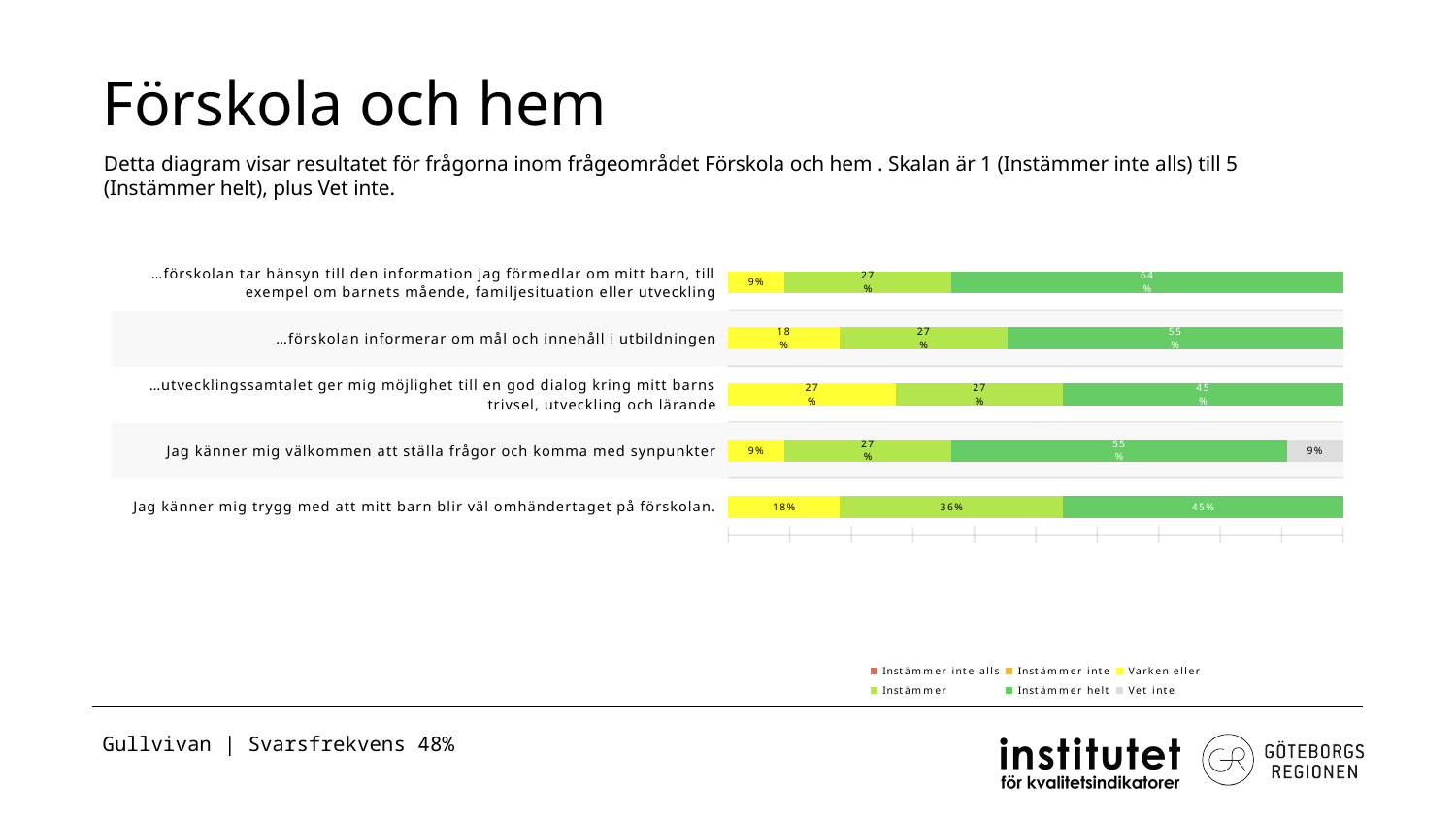
Which statement has the highest "Instämmer helt" share? …förskolan tar hänsyn till den information jag förmedlar om mitt barn, till exempel om barnets mående, familjesituation eller utveckling What is the "Instämmer" share for "Jag känner mig trygg med att mitt barn blir väl omhändertaget på förskolan."? 36% What kind of chart is shown on the slide? Stacked bar chart How many statements (bars) are shown in the chart? 5 What is the "Vet inte" share for "Jag känner mig välkommen att ställa frågor och komma med synpunkter"? 9% What is the "Varken eller" share for "…förskolan informerar om mål och innehåll i utbildningen"? 18% Which has the larger "Instämmer helt" share: "…förskolan informerar om mål och innehåll i utbildningen" or "…utvecklingssamtalet ger mig möjlighet till en god dialog…"? …förskolan informerar om mål och innehåll i utbildningen How many series does the legend list? 6 What percentage of respondents answered "Instämmer helt" for "…förskolan tar hänsyn till den information jag förmedlar om mitt barn, till exempel om barnets mående, familjesituation eller utveckling"? 64% Which statement has the highest "Varken eller" share? …utvecklingssamtalet ger mig möjlighet till en god dialog kring mitt barns trivsel, utveckling och lärande What is the total of the labelled segments for "Jag känner mig välkommen att ställa frågor och komma med synpunkter"? 100% How many percentage points higher is the "Instämmer helt" share for "…förskolan tar hänsyn till den information jag förmedlar om mitt barn…" than for "…förskolan informerar om mål och innehåll i utbildningen"? 9 percentage points